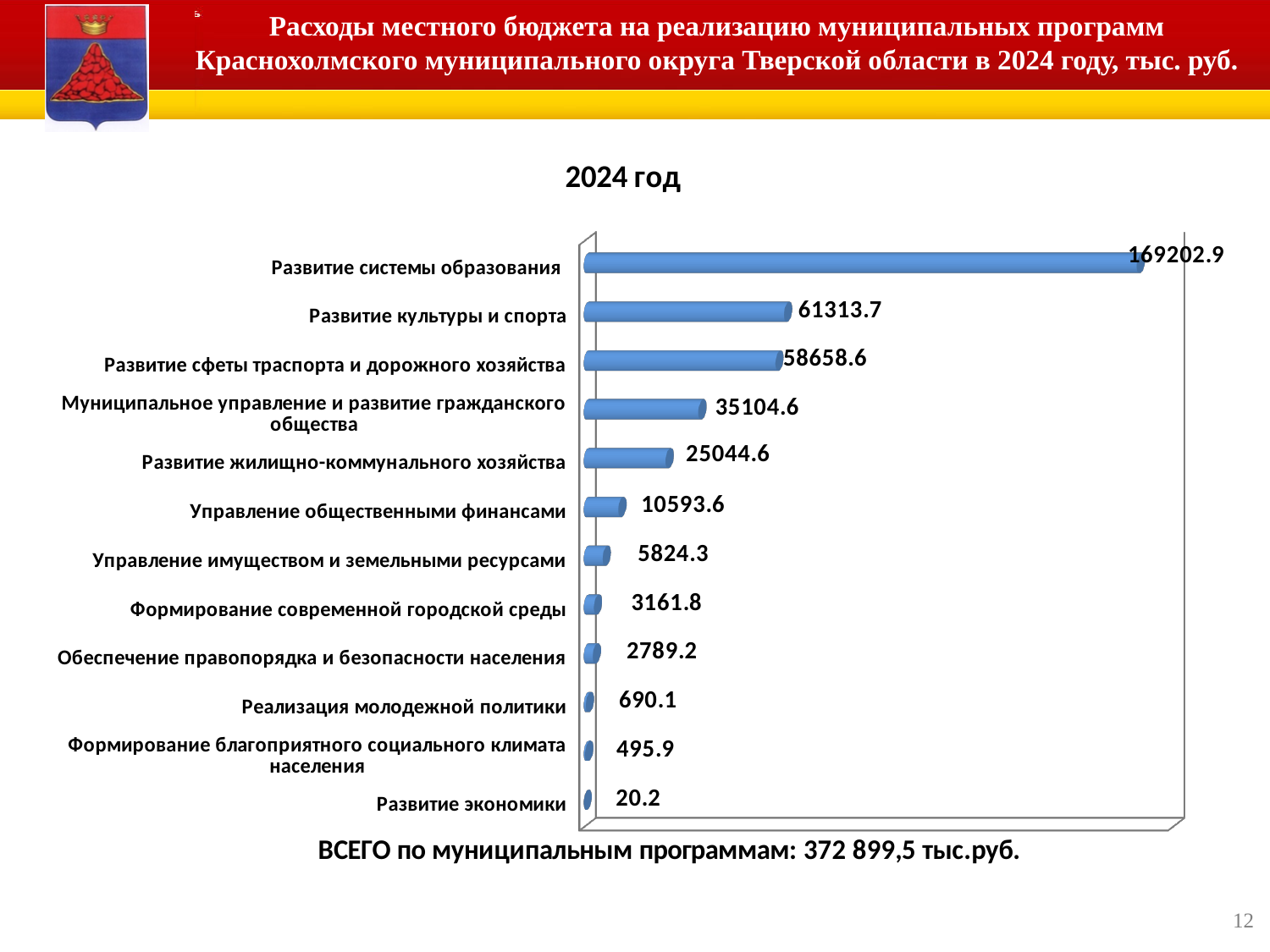
What is the value for «Управление общественными финансами»? 10593.6 What is the value for «Развитие жилищно-коммунального хозяйства»? 25044.6 What is the value for «Развитие системы образования»? 169202.9 What is the title shown above the chart? 2024 год What kind of chart is shown on the slide? Bar chart Which category has the lowest value? Развитие экономики What is the value for «Реализация молодежной политики»? 690.1 What is the difference between «Развитие культуры и спорта» and «Развитие сфеты траспорта и дорожного хозяйства»? 2655.1 Which category has the highest value? Развитие системы образования How many categories are shown in the chart? 12 What is the difference between «Формирование современной городской среды» and «Обеспечение правопорядка и безопасности населения»? 372.6 Which is larger: «Развитие культуры и спорта» or «Развитие сфеты траспорта и дорожного хозяйства»? Развитие культуры и спорта